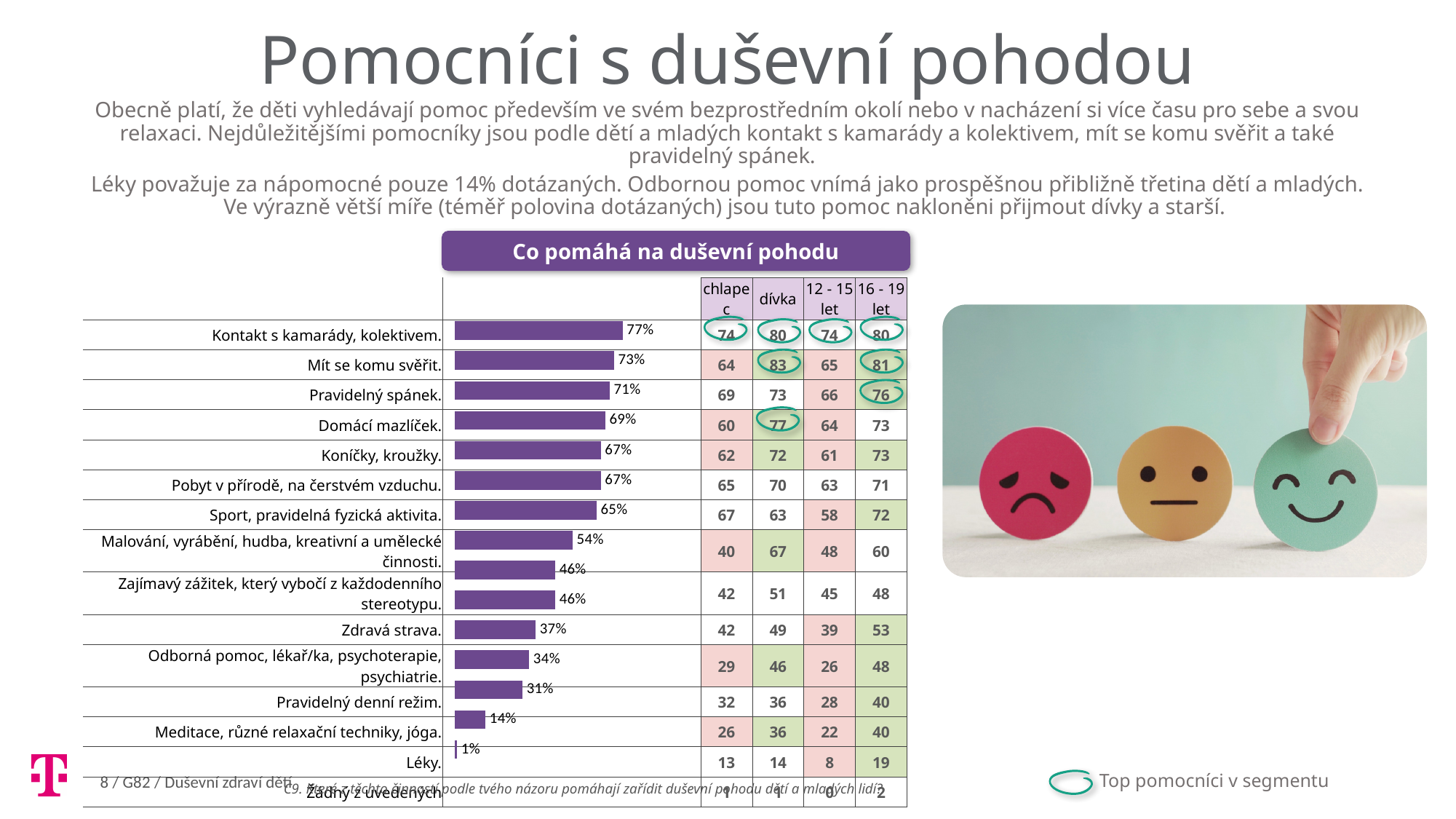
What is the value for 'Domácí mazlíček' in the bar chart? 69% Which is larger in the bar chart: 'Pravidelný spánek' or 'Sport, pravidelná fyzická aktivita'? Pravidelný spánek In the table next to the bar chart, what is the 'dívka' value for 'Mít se komu svěřit'? 83 What is the difference between the values for 'Kontakt s kamarády, kolektivem' and 'Mít se komu svěřit'? 4% What kind of chart is shown under the heading 'Co pomáhá na duševní pohodu'? bar chart What is the difference between the values for 'Domácí mazlíček' and 'Sport, pravidelná fyzická aktivita'? 4% Which category has the highest value in the bar chart? Kontakt s kamarády, kolektivem In the table next to the bar chart, what is the '16 - 19 let' value for 'Léky'? 19 What is the value for 'Pravidelný spánek' in the bar chart? 71% What is the title shown above the bar chart? Co pomáhá na duševní pohodu What is the value for 'Mít se komu svěřit' in the bar chart? 73% What is the value for 'Kontakt s kamarády, kolektivem' in the bar chart? 77%